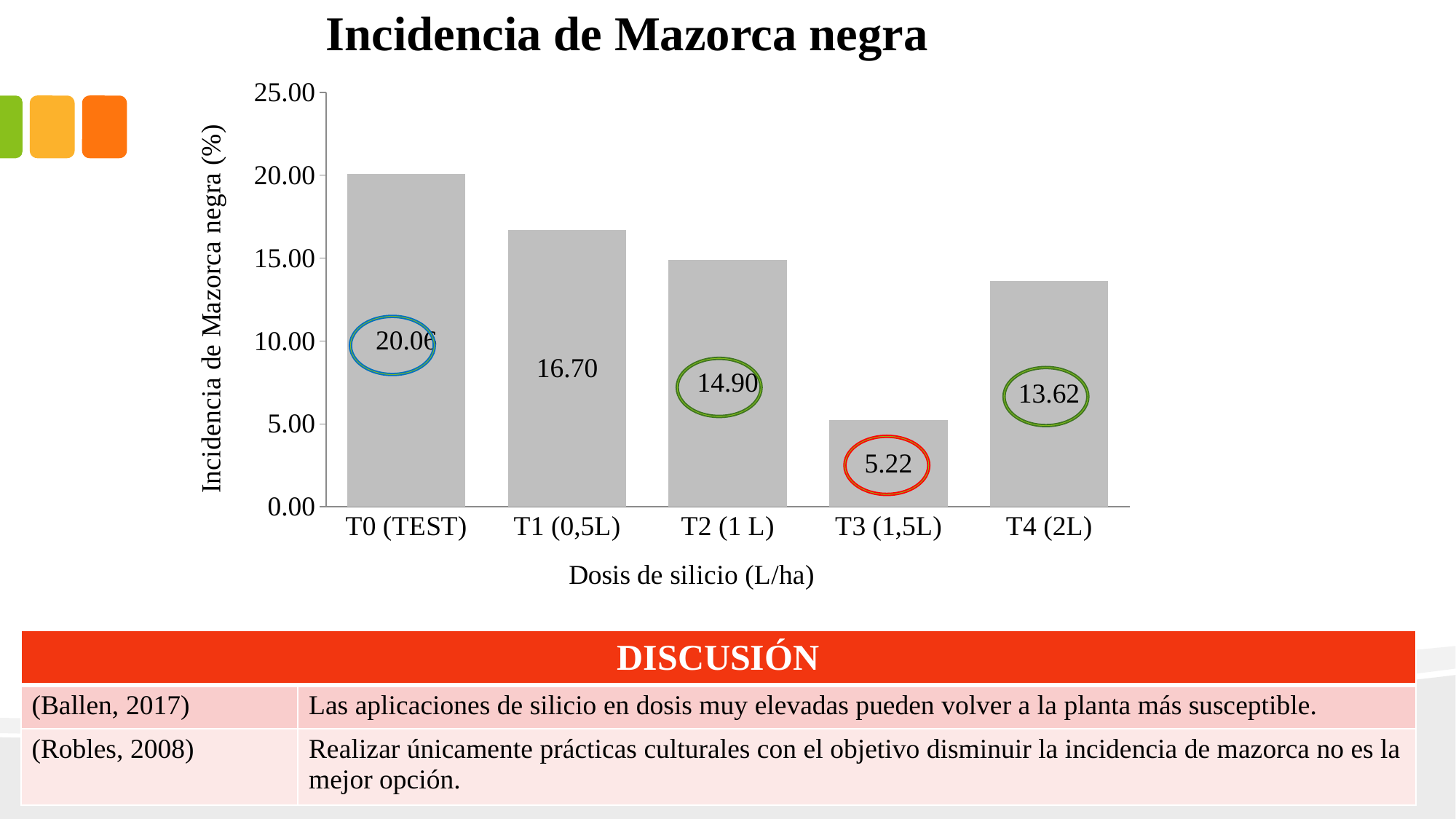
What kind of chart is this? bar chart What is the value for T4 (2L)? 13.62 What is the difference between the values for T0 (TEST) and T3 (1,5L)? 14.84 What is the value for T3 (1,5L)? 5.22 Which is larger, the value for T2 (1 L) or the value for T4 (2L)? T2 (1 L) What is the title of the chart? Incidencia de Mazorca negra What is the value for T0 (TEST)? 20.06 Which category has the lowest incidence? T3 (1,5L) How many categories are shown on the x axis? 5 Which category has the highest incidence? T0 (TEST) Is the value for T1 (0,5L) greater or less than 15.00? greater What is the value for T1 (0,5L)? 16.70